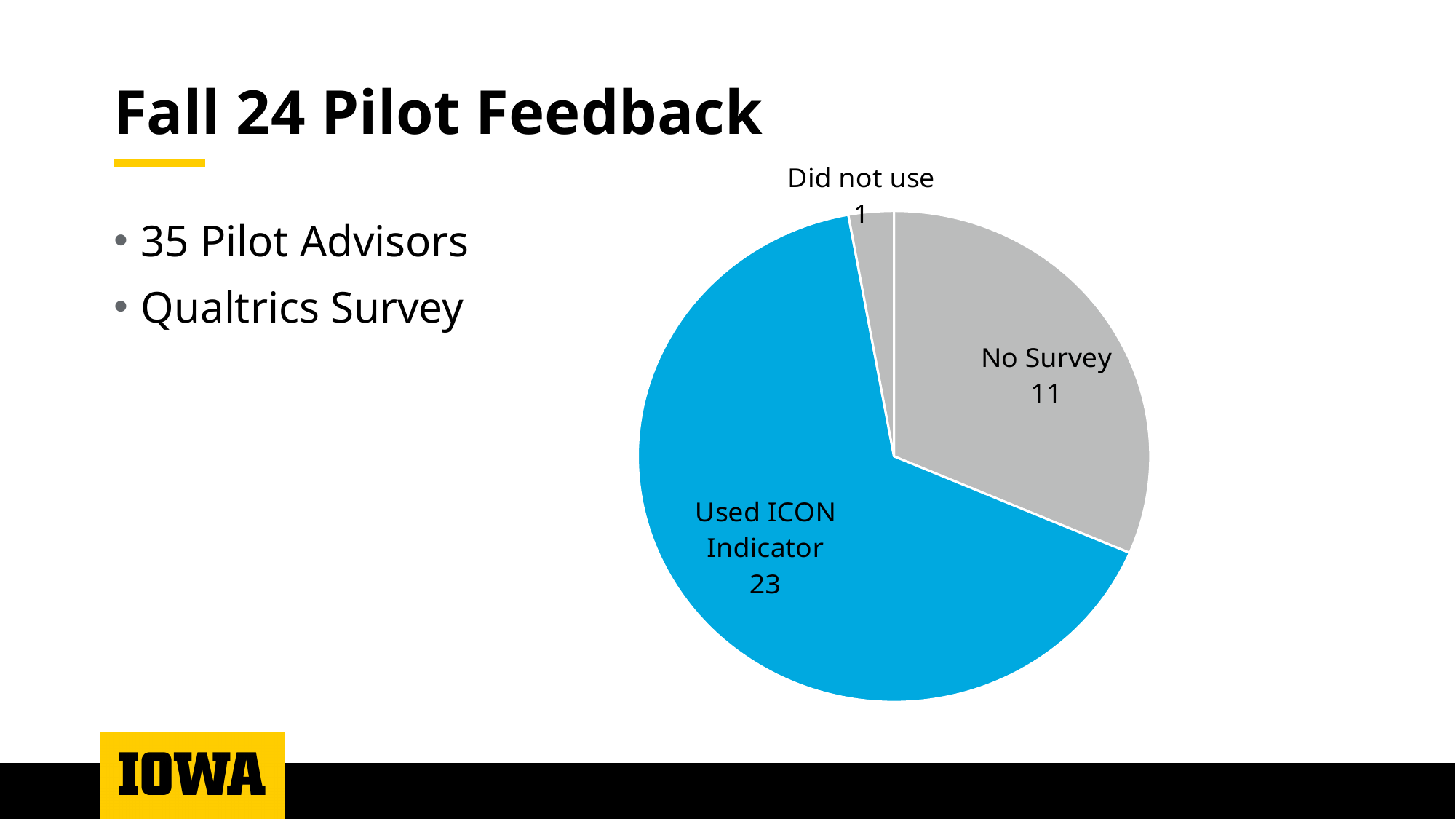
Which category has the largest slice? Used ICON Indicator What is the value for Used ICON Indicator? 23 What is the value for Did not use? 1 Which is larger, No Survey or Did not use? No Survey What colour is the No Survey slice? grey What is the value for No Survey? 11 What is the difference between Used ICON Indicator and No Survey? 12 What is the total of all slices in the pie chart? 35 Which category has the smallest slice? Did not use How many slices does the pie chart have? 3 What kind of chart is shown on the slide? pie chart What colour is the Used ICON Indicator slice? blue